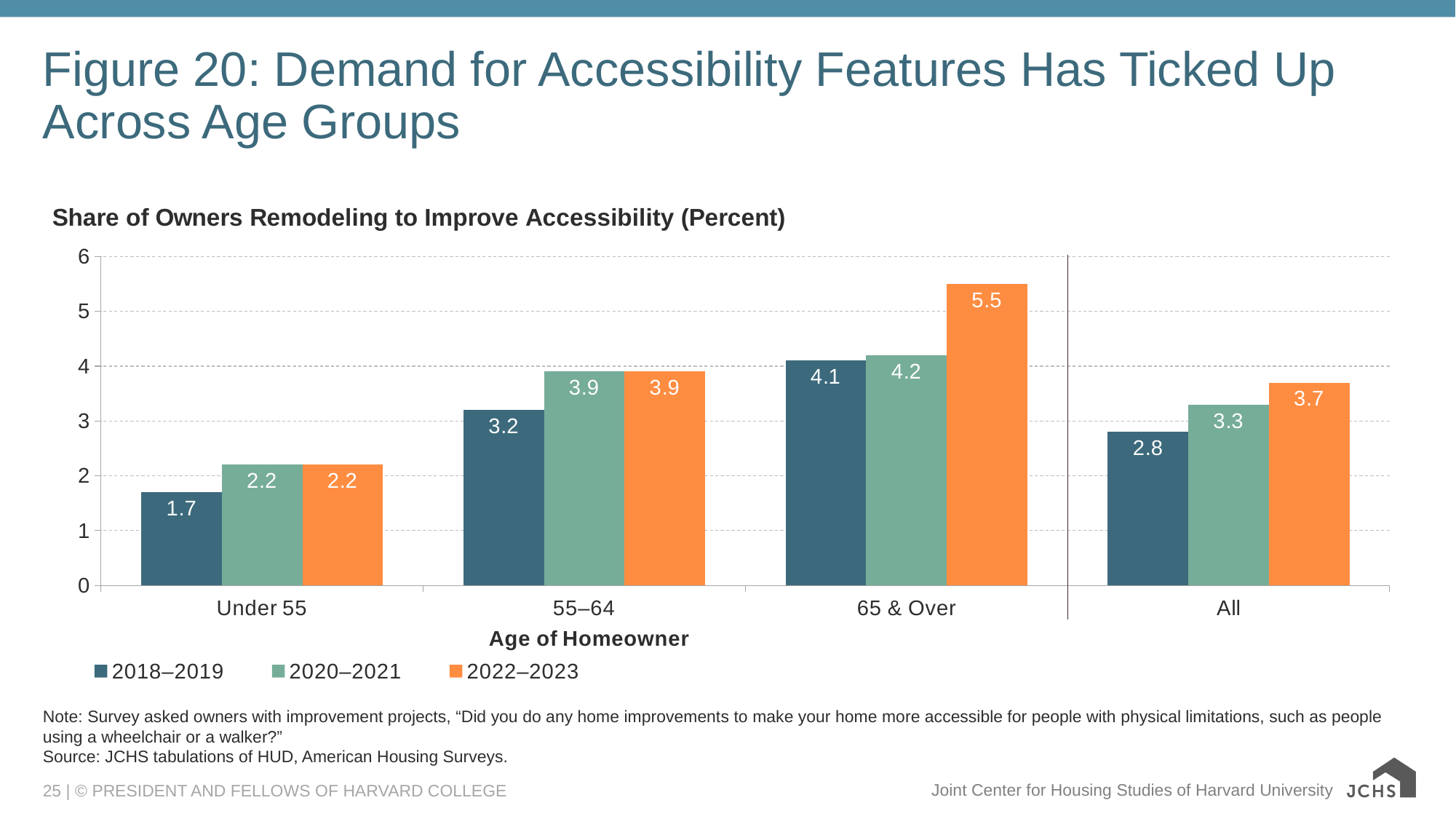
Which category has the lowest value in the 2018–2019 series? Under 55 Is the 2022–2023 value for All greater or less than 3? greater What is the x-axis title of the chart? Age of Homeowner What is the value for 65 & Over in the 2022–2023 series? 5.5 What kind of chart is shown? bar chart Which is larger for 55–64: the 2018–2019 value or the 2020–2021 value? 2020–2021 How many categories are shown on the x axis? 4 What is the difference between the 2022–2023 and 2018–2019 values for 65 & Over? 1.4 Which age group has the highest value in the 2022–2023 series? 65 & Over How many series does the legend list? 3 What is the value for Under 55 in the 2018–2019 series? 1.7 What is the value for All in the 2020–2021 series? 3.3